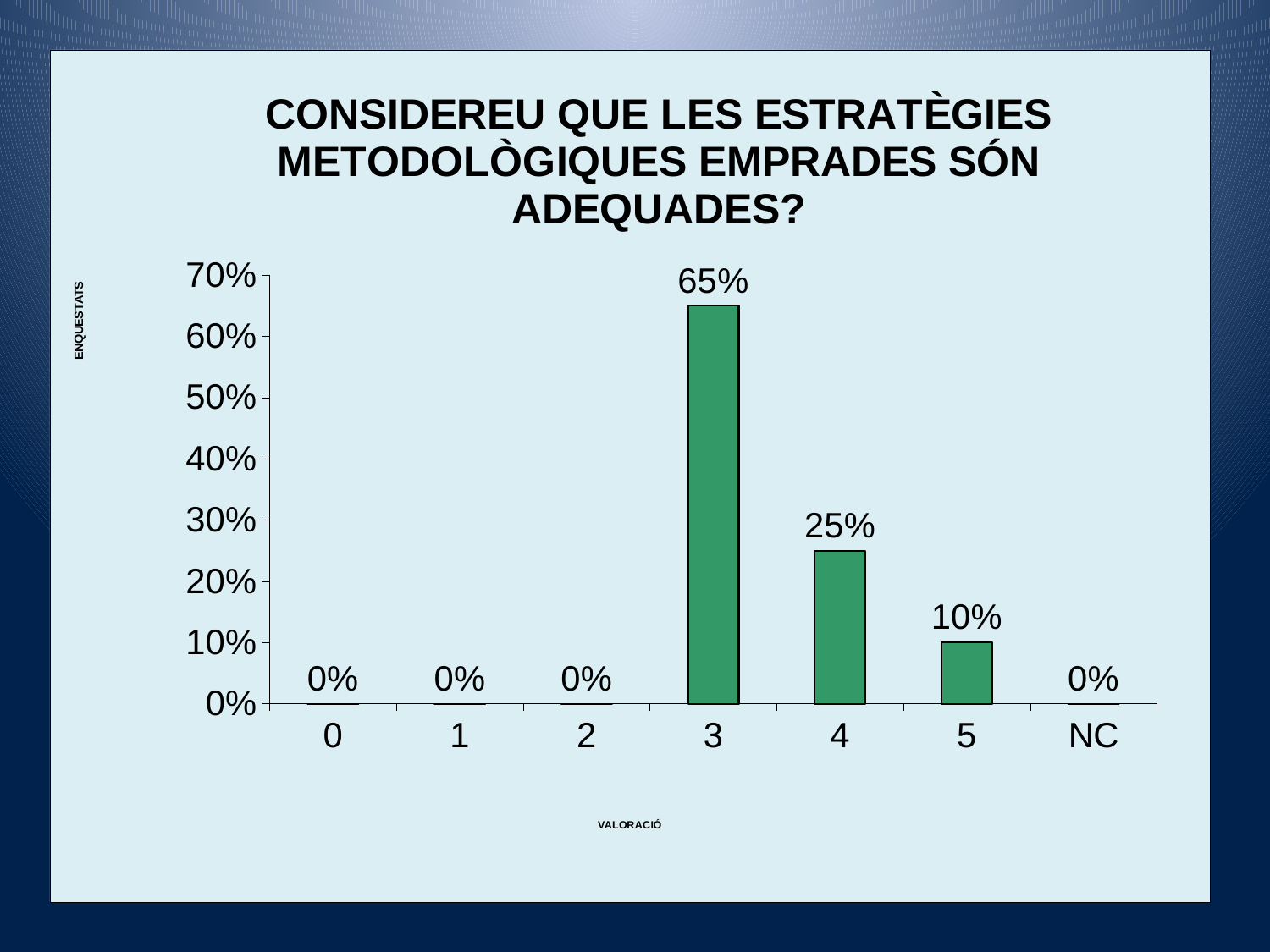
What is the value for category 4? 25% What is the label of the x axis? VALORACIÓ Which category has the highest value? 3 What is the difference between the values for 4 and 5? 15% Which is larger, the value for 4 or the value for 5? 4 What is the value for category 3? 65% How many categories are shown on the x axis? 7 What kind of chart is this? bar chart What is the value for category 5? 10% What is the value for NC? 0% What is the difference between the values for 3 and 4? 40% Is the value for category 3 greater or less than 60%? greater